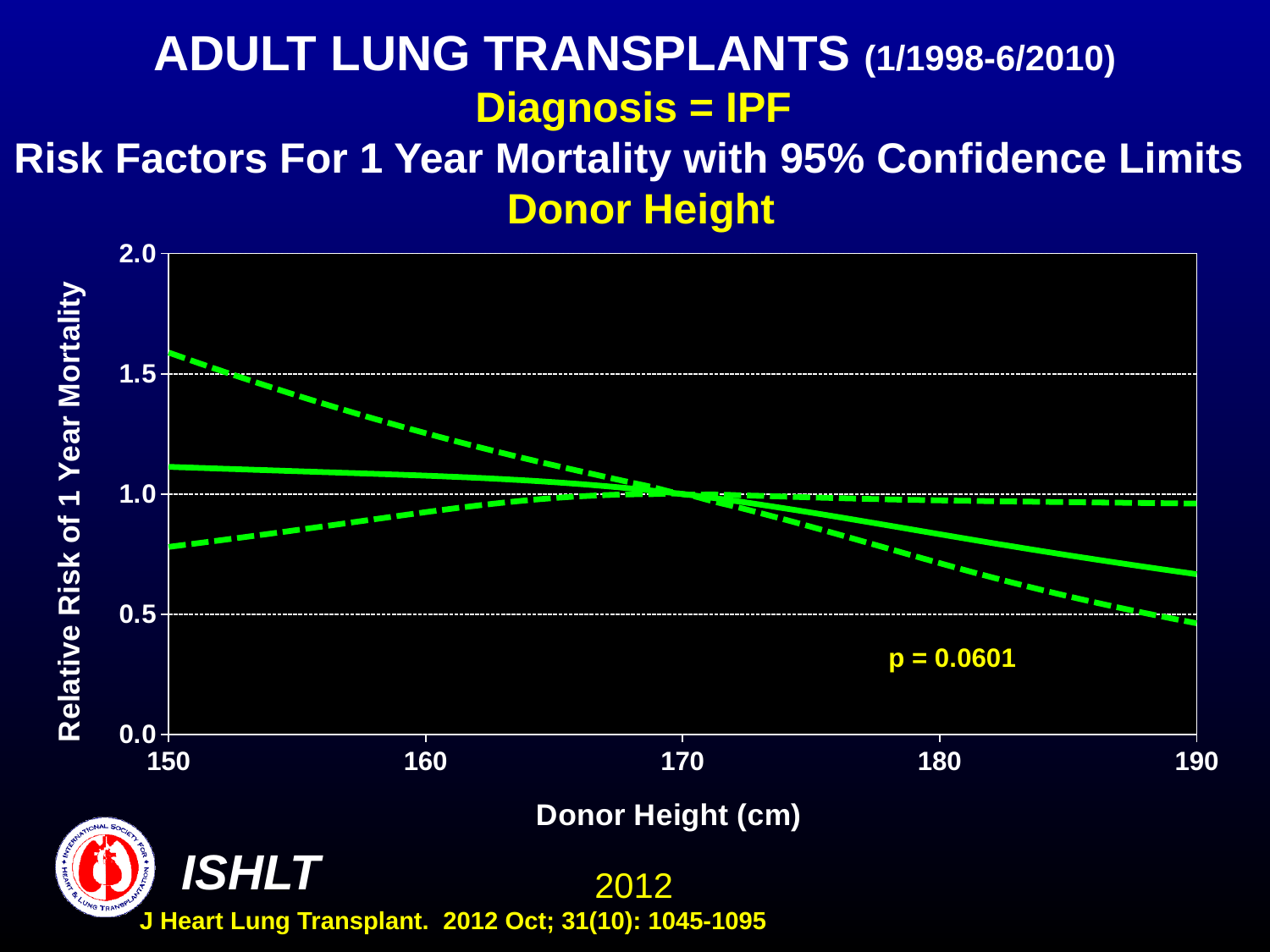
Is the upper dashed confidence limit at a donor height of 150 cm greater or less than 1.5? greater Is the value of the solid relative risk line at a donor height of 150 cm greater or less than 1.0? greater How many lines are plotted on the chart? 3 Is the solid relative risk line higher at a donor height of 150 cm or at 190 cm? 150 cm What p-value is printed on the chart? p = 0.0601 Is the lower dashed confidence limit at a donor height of 150 cm greater or less than 1.0? less Does the solid line for relative risk of 1 year mortality rise or fall as donor height increases from 150 cm to 190 cm? fall What is the label of the x axis? Donor Height (cm) What kind of chart is shown on the slide? line chart